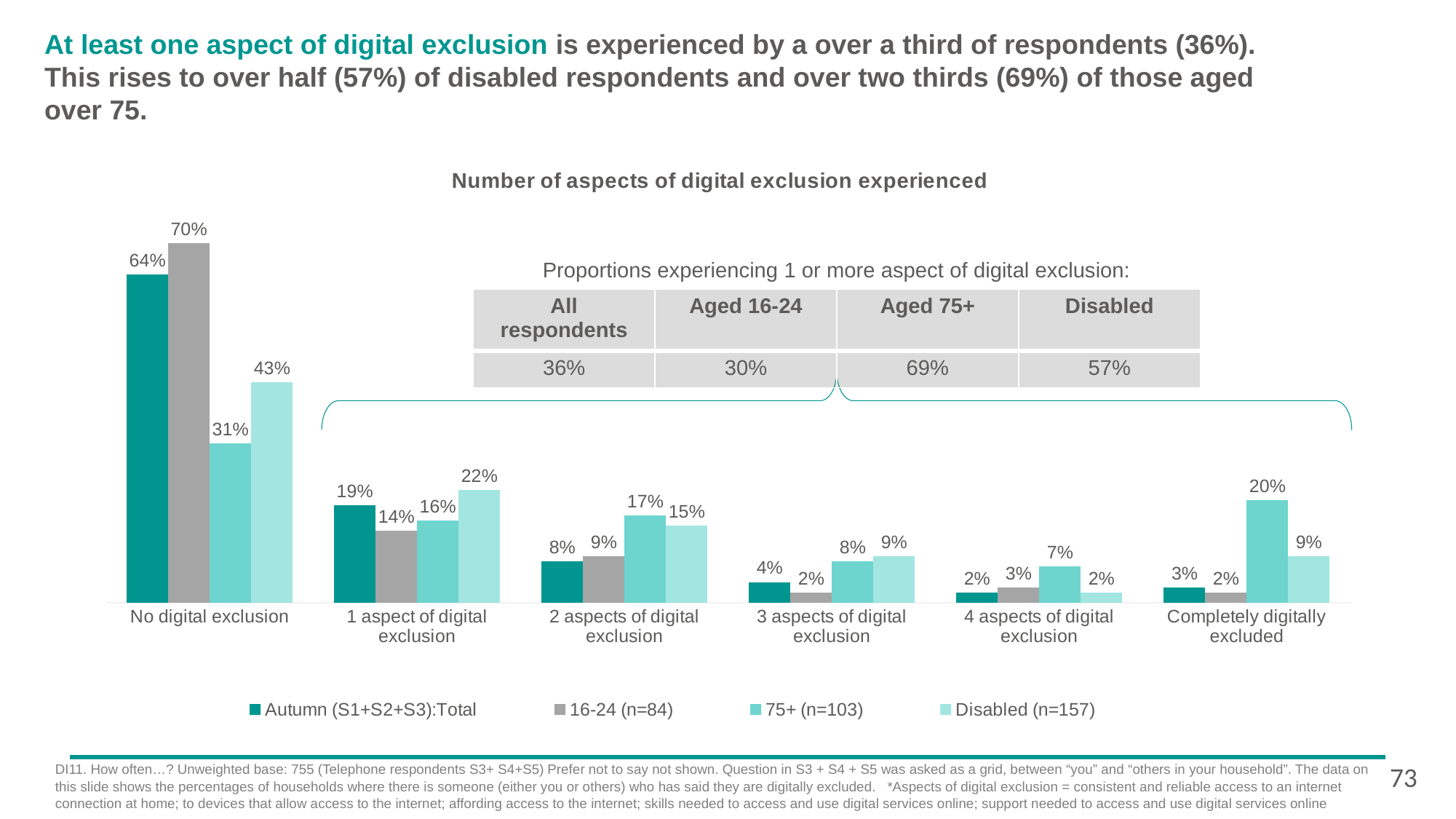
What is the value for the Disabled (n=157) series in the '1 aspect of digital exclusion' category? 22% What is the title of the chart? Number of aspects of digital exclusion experienced What is the value for the 75+ (n=103) series in the 'Completely digitally excluded' category? 20% What is the difference between the 16-24 (n=84) and Autumn (S1+S2+S3):Total values in the 'No digital exclusion' category? 6% What type of chart is shown on the slide? Bar chart What is the difference between the 75+ (n=103) and Disabled (n=157) values in the 'Completely digitally excluded' category? 11% Which series has the highest value in the 'No digital exclusion' category? 16-24 (n=84) Which series has the lowest value in the '3 aspects of digital exclusion' category? 16-24 (n=84) How many series does the chart legend list? 4 What is the value for the 75+ (n=103) series in the 'No digital exclusion' category? 31% In the '2 aspects of digital exclusion' category, which is larger: the 75+ (n=103) value or the Disabled (n=157) value? 75+ (n=103) How many categories are shown along the x axis of the chart? 6